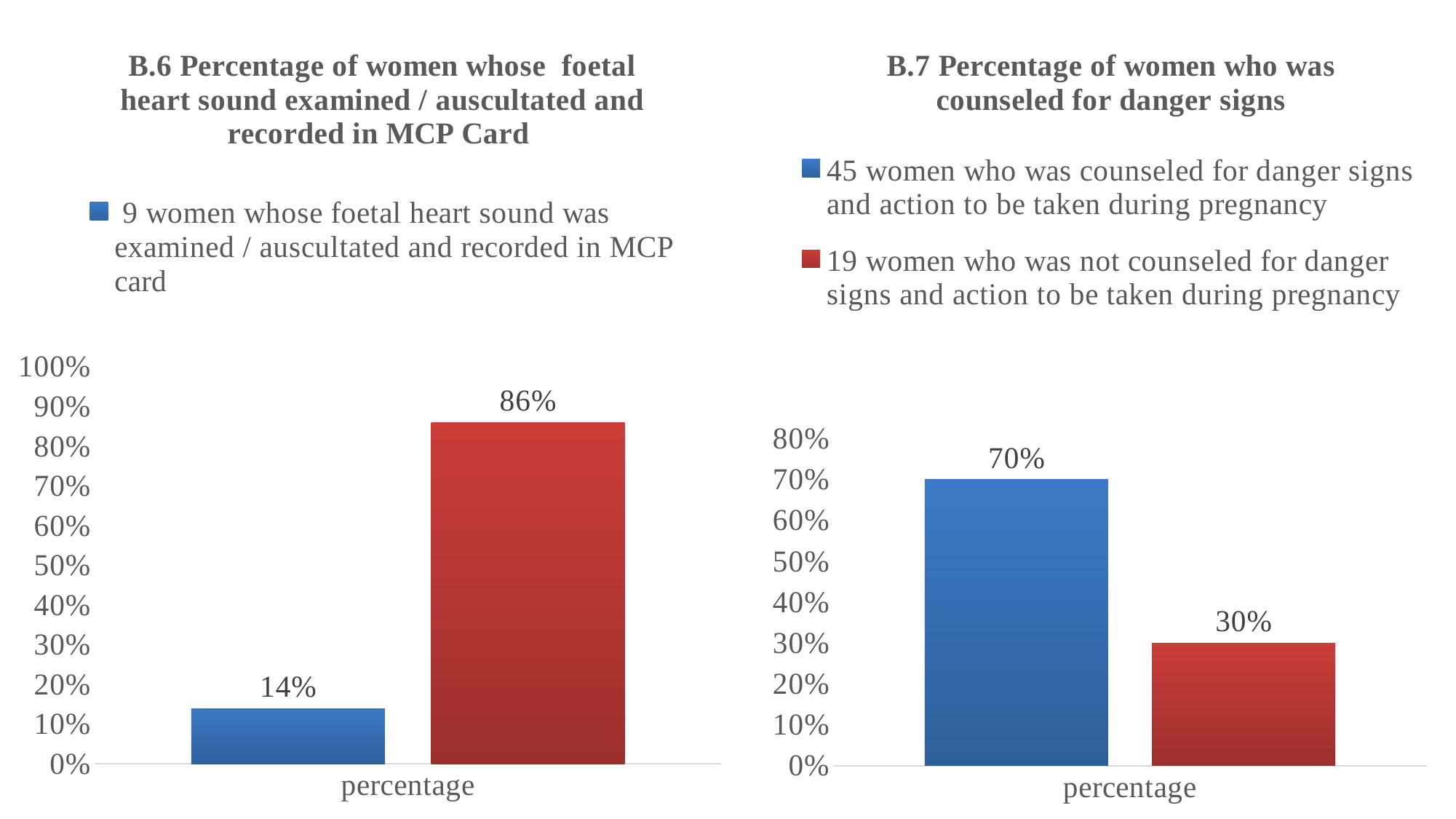
In the B.7 chart, what colour is the bar for the women who was not counseled for danger signs? red In the B.6 chart, what is the value for the 9 women whose foetal heart sound was examined / auscultated and recorded in MCP card? 14% In the B.7 chart, which series has the higher value? 45 women who was counseled for danger signs and action to be taken during pregnancy In the B.6 chart, how many entries does the legend list? 1 In the B.7 chart, how many series does the legend list? 2 In the B.6 chart, is the value for the 9 women whose foetal heart sound was examined greater or less than 20%? less In the B.6 chart, what value is labelled on the red bar? 86% In the B.6 chart, what is the difference between the red bar and the blue bar? 72% In the B.7 chart, what is the difference between the counseled and not counseled percentages? 40% In the B.7 chart, what is the value for the 45 women who was counseled for danger signs and action to be taken during pregnancy? 70% In the B.7 chart, what is the value for the 19 women who was not counseled for danger signs and action to be taken during pregnancy? 30% What kind of chart is the B.7 chart? bar chart